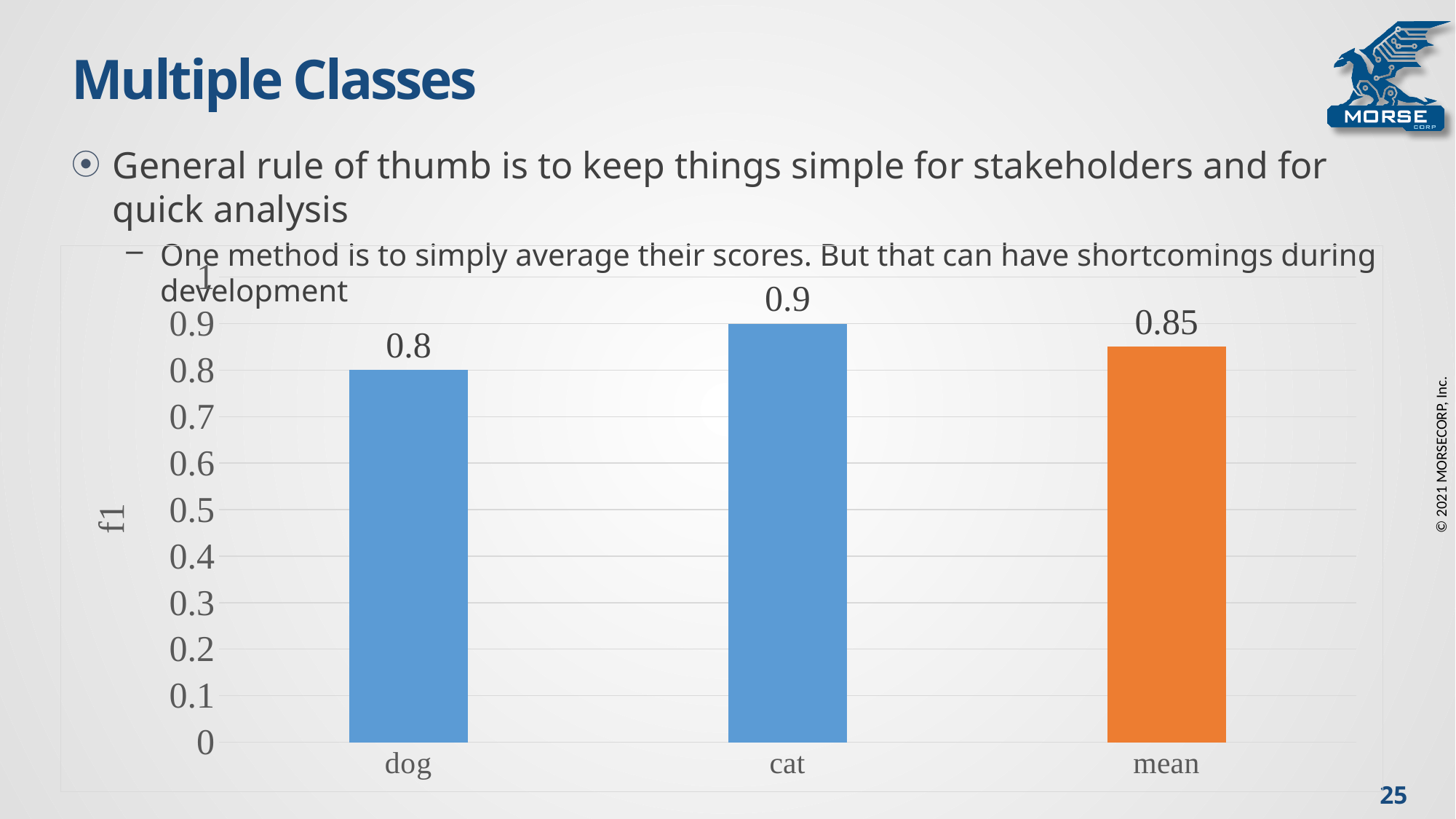
What is the difference between the f1 values for mean and dog? 0.05 What is the label of the vertical axis? f1 Which category has the lowest f1 value? dog Which category has the highest f1 value? cat Is the value for cat greater or less than 0.8? greater How many categories are shown on the x axis? 3 What is the f1 value for dog? 0.8 What is the difference between the f1 values for cat and dog? 0.1 What is the f1 value for mean? 0.85 Which has a larger f1 value, dog or mean? mean What is the f1 value for cat? 0.9 What kind of chart is shown on the slide? bar chart